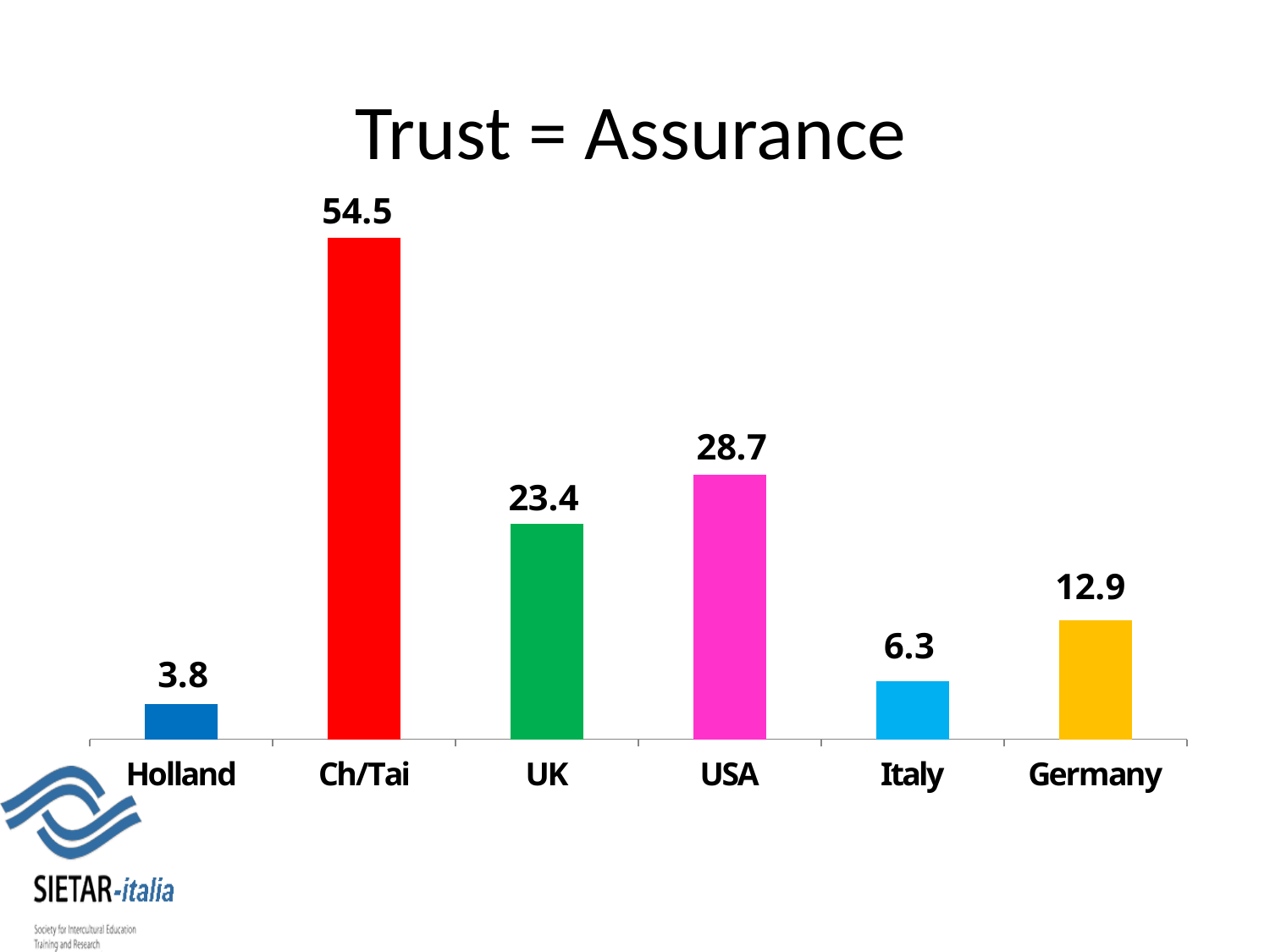
Which category has the highest value? Ch/Tai What is the difference between the values for USA and UK? 5.3 What is the title of the slide? Trust = Assurance What is the difference between the values for Germany and Italy? 6.6 Which is larger, the value for UK or the value for USA? USA What is the value for Ch/Tai? 54.5 What is the value for USA? 28.7 What is the value for Holland? 3.8 What is the value for Germany? 12.9 How many categories are shown on the x axis? 6 What kind of chart is shown on the slide? Bar chart Which category has the lowest value? Holland